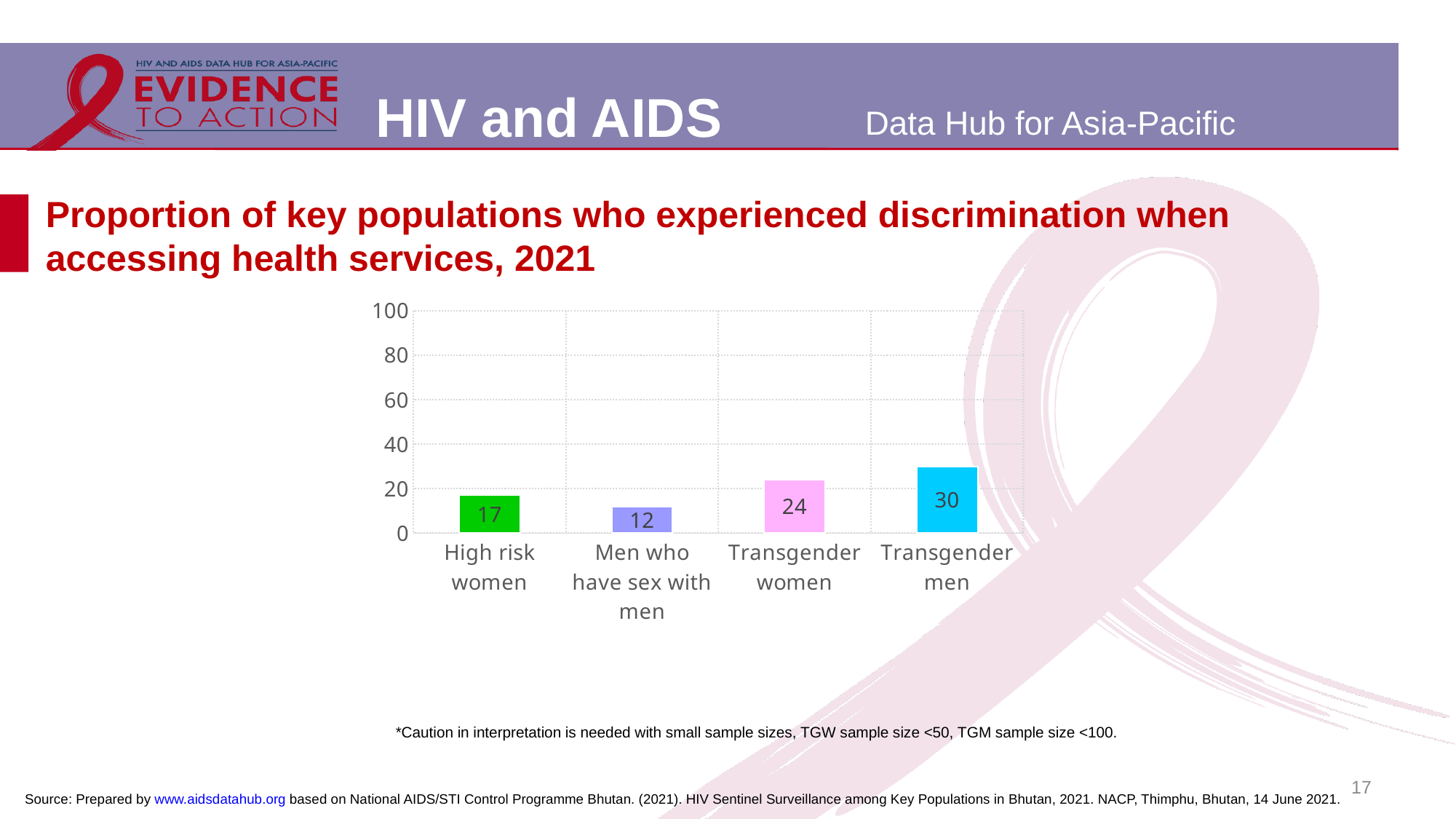
Which is larger, the value for High risk women or the value for Transgender women? Transgender women What kind of chart is shown on the slide? bar chart What is the value for Transgender men? 30 What is the value for Transgender women? 24 How many categories are shown on the chart? 4 Which category has the lowest value? Men who have sex with men What is the value for Men who have sex with men? 12 What is the difference between the values for Transgender women and High risk women? 7 What is the difference between the values for Transgender men and Men who have sex with men? 18 Which category has the highest value? Transgender men Is the value for Transgender men greater or less than 40? less What is the value for High risk women? 17